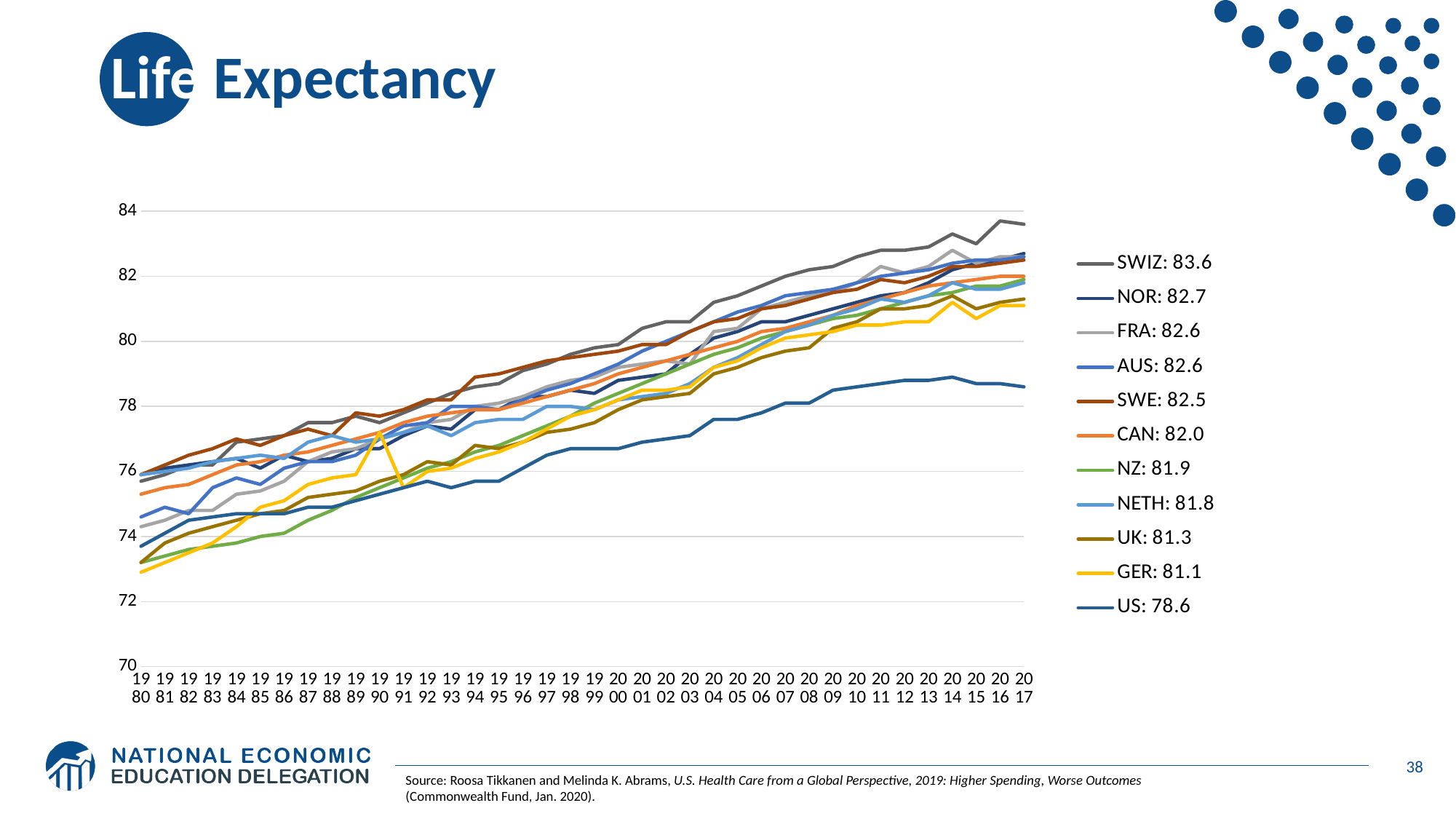
What is the first year shown on the x axis? 1980 Is the US value in 2017 greater or less than 80? less Which country has the lowest value in the legend? US What is the difference between the legend values for SWIZ and US? 5.0 What kind of chart is shown on the slide? line chart What value does the legend show for UK? 81.3 Which has the larger legend value, CAN or GER? CAN Does the US line generally rise or fall from 1980 to 2017? rise What value does the legend show for SWIZ? 83.6 Which country has the highest value in the legend? SWIZ How many series does the legend list? 11 What value does the legend show for US? 78.6